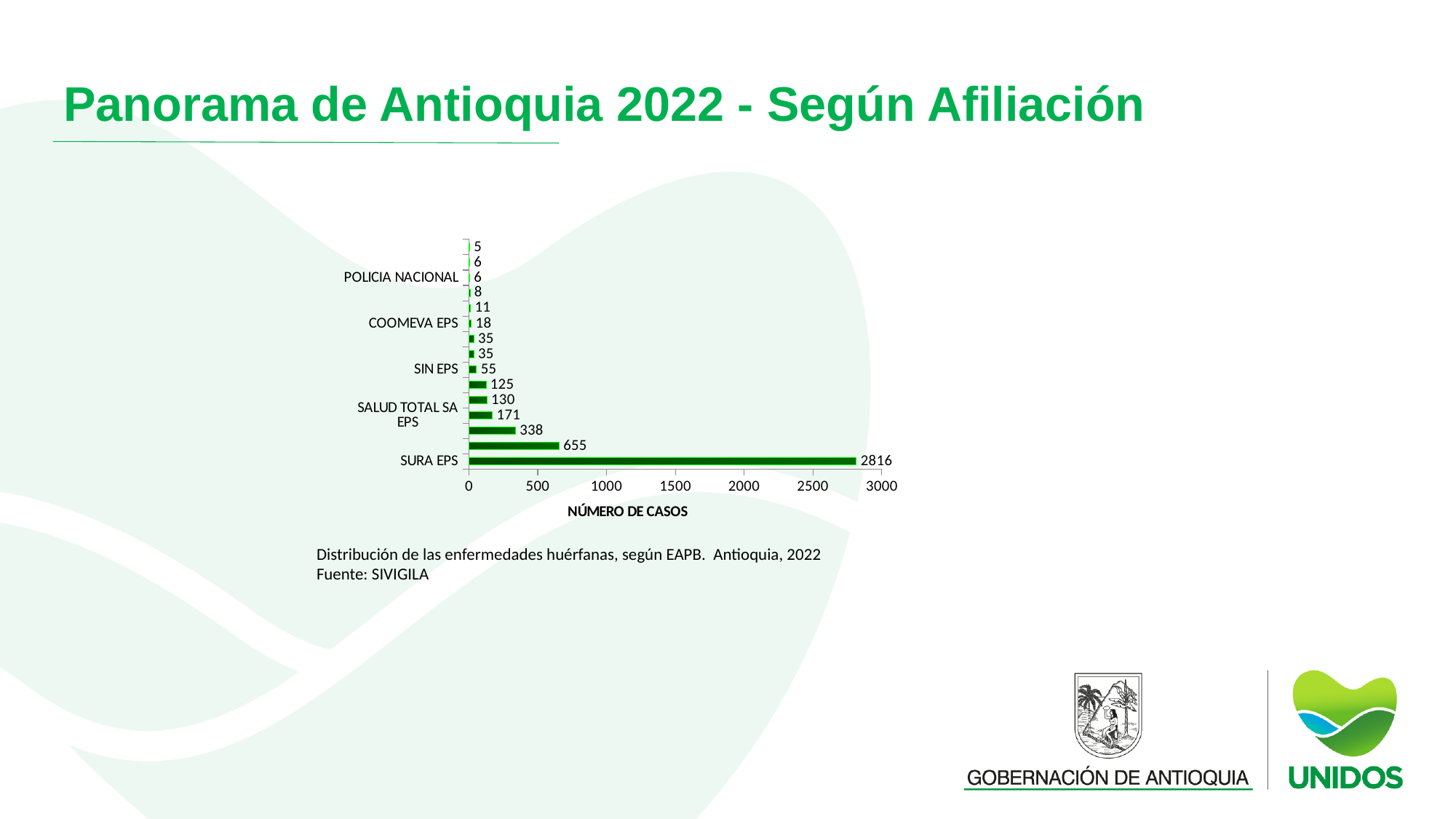
What is the number of cases for SURA EPS? 2816 What is the number of cases for SALUD TOTAL SA EPS? 171 Is the value for SURA EPS greater or less than 2500? greater Which has more cases, SIN EPS or COOMEVA EPS? SIN EPS What is the difference in cases between SURA EPS and SALUD TOTAL SA EPS? 2645 Which labelled category has the highest number of cases? SURA EPS What kind of chart is shown on the slide? Bar chart What is the smallest value shown on the chart? 5 What is the number of cases for SIN EPS? 55 What is the number of cases for POLICIA NACIONAL? 6 How many bars are plotted on the chart? 15 What is the number of cases for COOMEVA EPS? 18